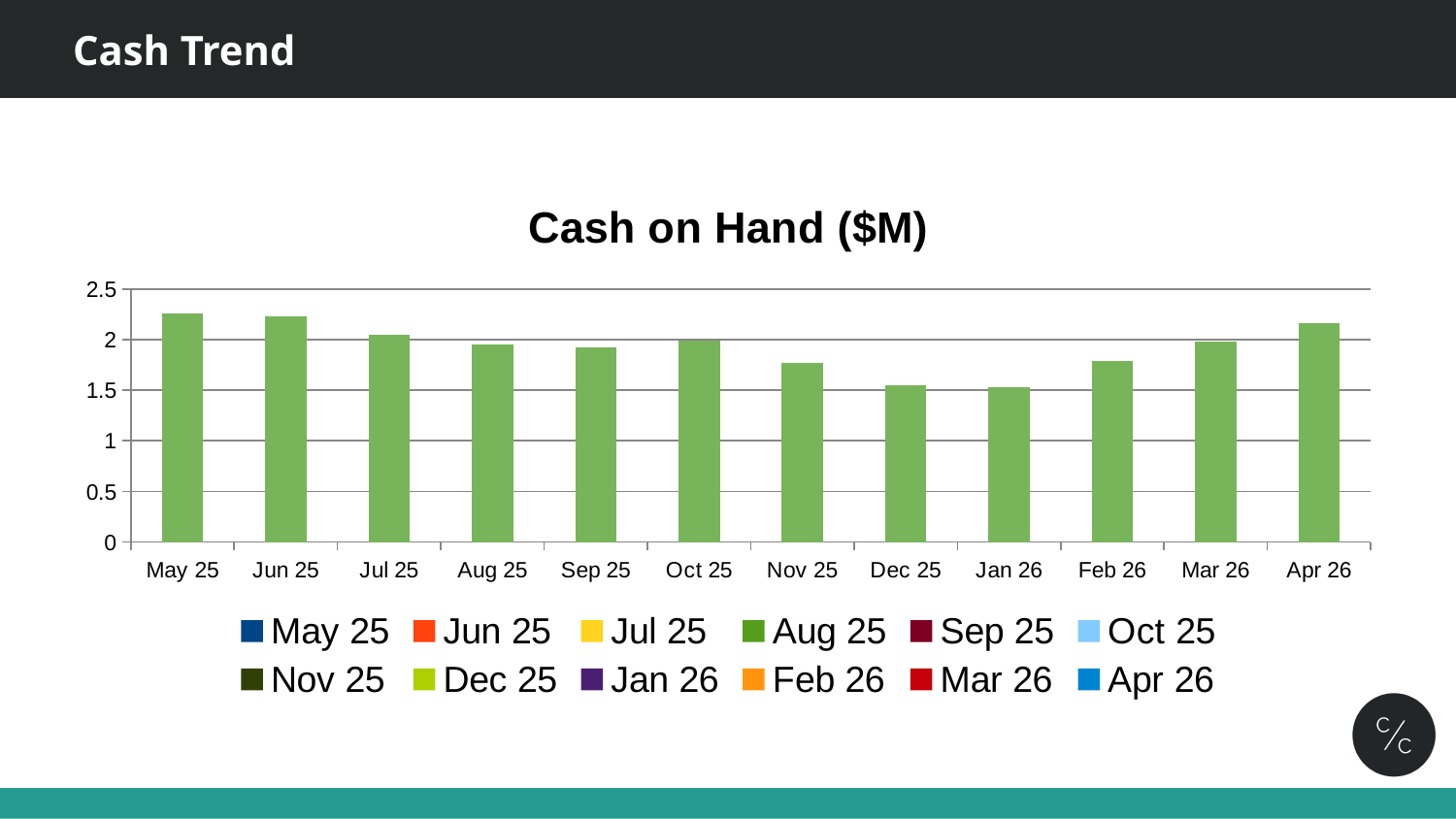
Is the value for Dec 25 greater or less than 2? less Which is larger, the value for May 25 or the value for Dec 25? May 25 Which is larger, the value for Jan 26 or the value for Apr 26? Apr 26 Is the value for Aug 25 greater or less than 2? less How many months are plotted on the x axis of the chart? 12 Is the value for Apr 26 greater or less than 2? greater Do the values generally rise or fall from May 25 to Jan 26? fall What kind of chart is shown on the slide? bar chart How many entries does the legend list? 12 What is the title of the chart? Cash on Hand ($M)